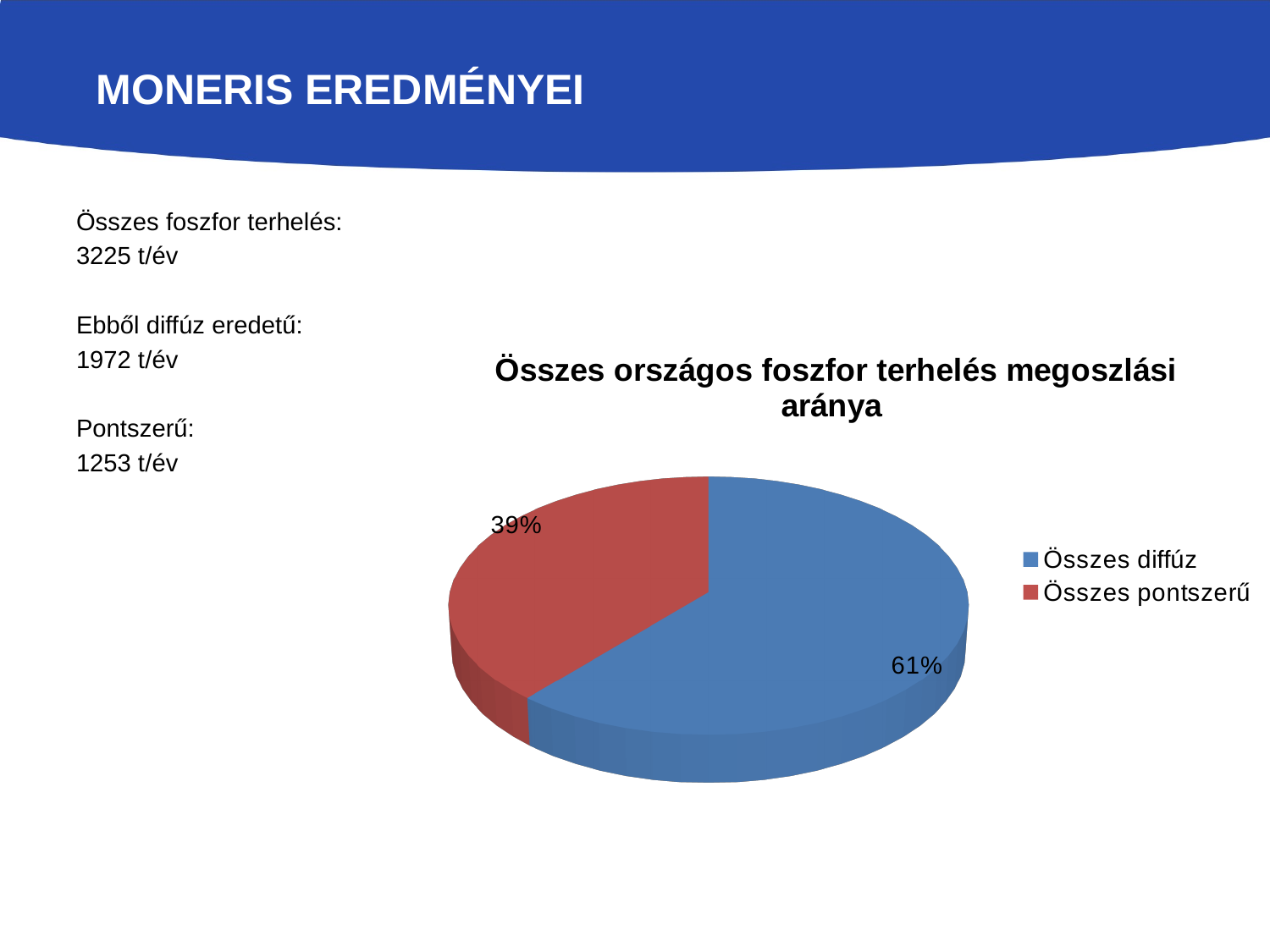
What is the title of the chart? Összes országos foszfor terhelés megoszlási aránya What share of the pie does Összes diffúz represent? 61% Which slice of the pie is the smallest? Összes pontszerű What is the difference in percentage points between the Összes diffúz and Összes pontszerű slices? 22 Is the share for Összes diffúz greater or less than 50%? greater Which is larger, the Összes diffúz slice or the Összes pontszerű slice? Összes diffúz What kind of chart is shown on the slide? pie chart What colour is the Összes pontszerű slice? red How many slices does the pie chart have? 2 How many entries does the legend list? 2 Which slice of the pie is the largest? Összes diffúz What share of the pie does Összes pontszerű represent? 39%